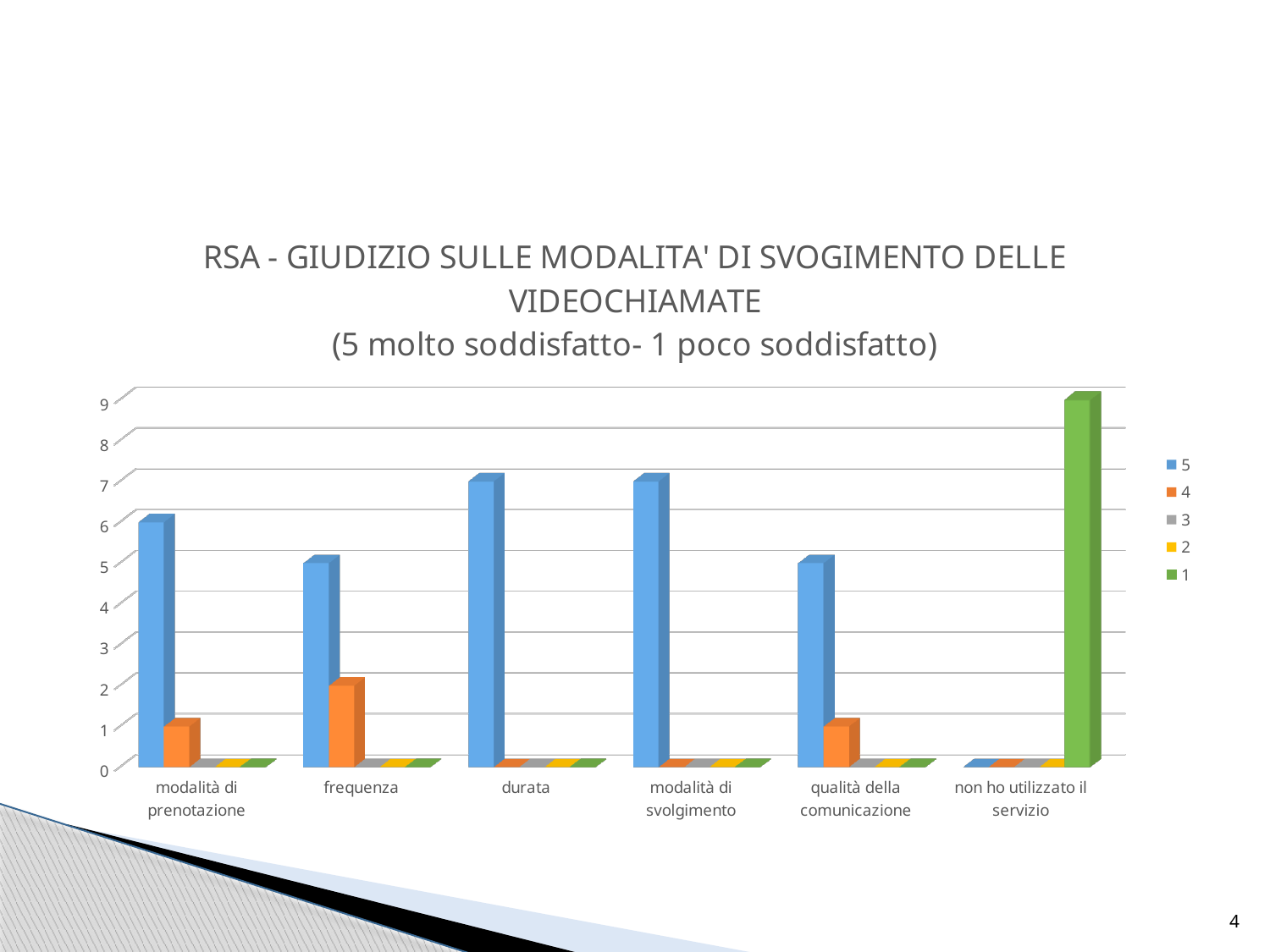
What is the value of series 5 for 'modalità di prenotazione'? 6 Which category has the highest bar for series 1? non ho utilizzato il servizio What is the difference between series 5 and series 4 for 'modalità di prenotazione'? 5 How many categories are shown on the x axis? 6 What kind of chart is shown on the slide? bar chart Is the value of series 5 for 'modalità di svolgimento' greater or less than 6? greater Which is larger: series 5 for 'frequenza' or series 5 for 'durata'? durata What is the value of series 1 for 'non ho utilizzato il servizio'? 9 What is the value of series 5 for 'durata'? 7 Is the value of series 5 for 'qualità della comunicazione' greater or less than 6? less What is the value of series 4 for 'frequenza'? 2 How many series does the legend list? 5